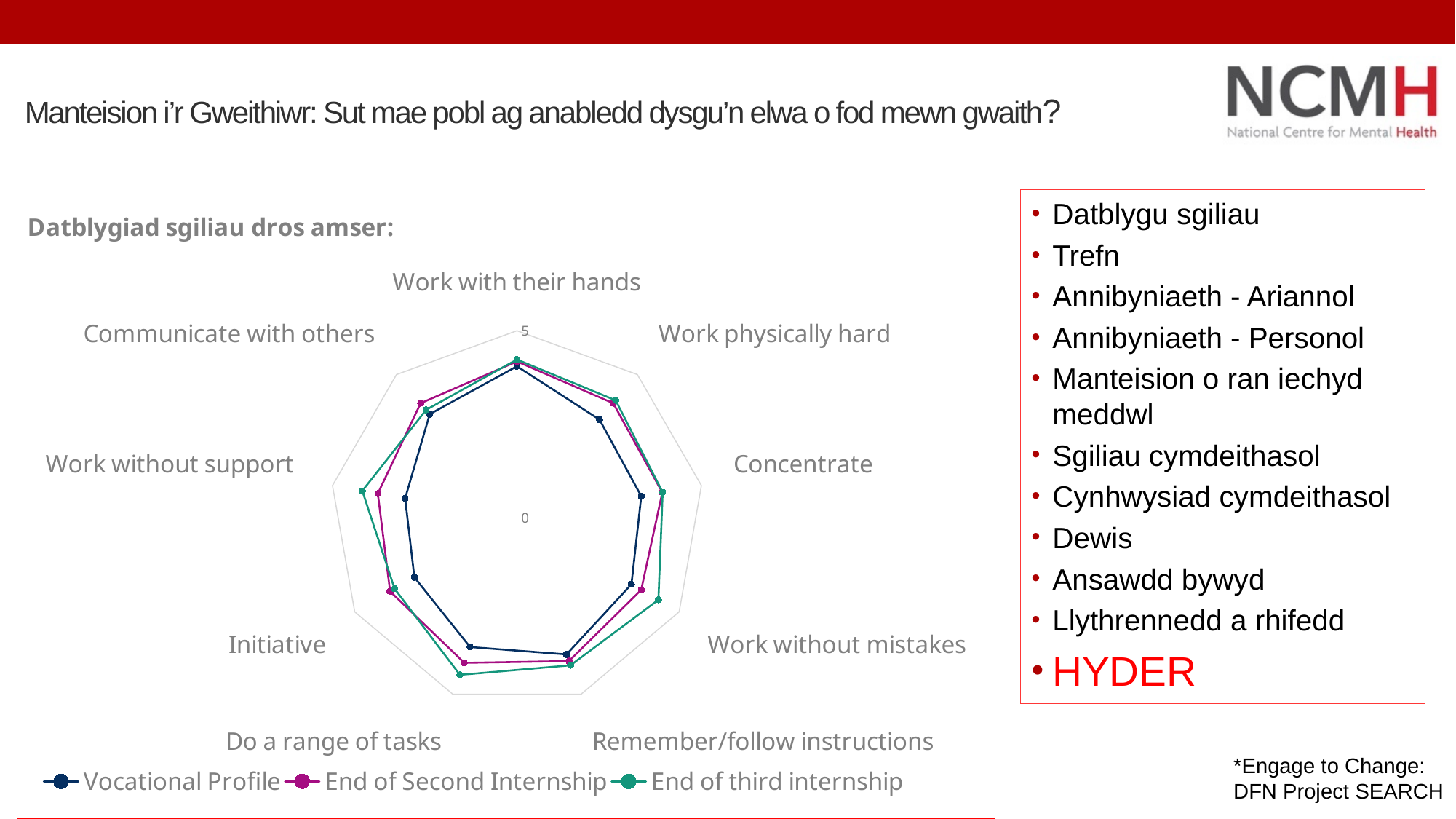
Is the Vocational Profile value for 'Work with their hands' greater or less than 5? less For 'Work without support', which is larger: the Vocational Profile value or the End of third internship value? End of third internship How many series does the chart legend list? 3 What kind of chart is shown on the slide? Radar chart What is the maximum value shown on the chart's axis scale? 5 For 'Work physically hard', which is larger: the Vocational Profile value or the End of Second Internship value? End of Second Internship What is the title of the chart? Datblygiad sgiliau dros amser: For 'Do a range of tasks', which is larger: the Vocational Profile value or the End of third internship value? End of third internship How many categories (skills) are plotted on the radar chart? 9 Which series are listed in the chart legend? Vocational Profile, End of Second Internship, End of third internship